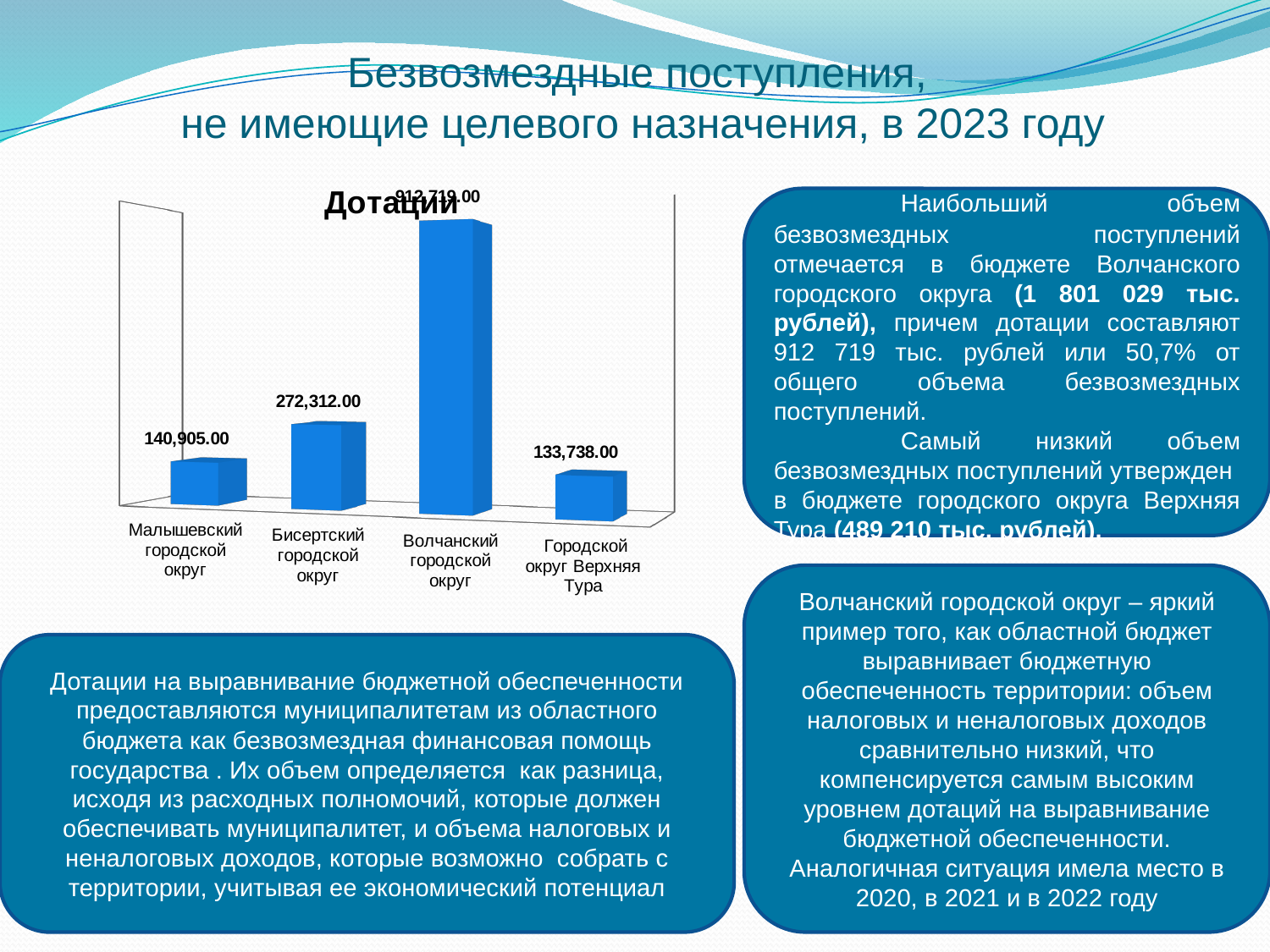
How many categories are shown in the Дотации chart? 4 What is the value for Городской округ Верхняя Тура in the Дотации chart? 133,738.00 What is the value for Волчанский городской округ in the Дотации chart? 912,719.00 What is the value for Малышевский городской округ in the Дотации chart? 140,905.00 Which is larger in the Дотации chart: the value for Бисертский городской округ or the value for Малышевский городской округ? Бисертский городской округ What is the value for Бисертский городской округ in the Дотации chart? 272,312.00 What is the title of the chart on the slide? Дотации Which category has the highest value in the Дотации chart? Волчанский городской округ Which category has the lowest value in the Дотации chart? Городской округ Верхняя Тура What kind of chart is used to show the Дотации data? Bar chart What is the difference between the values for Малышевский городской округ and Городской округ Верхняя Тура in the Дотации chart? 7,167.00 What is the difference between the values for Бисертский городской округ and Малышевский городской округ in the Дотации chart? 131,407.00